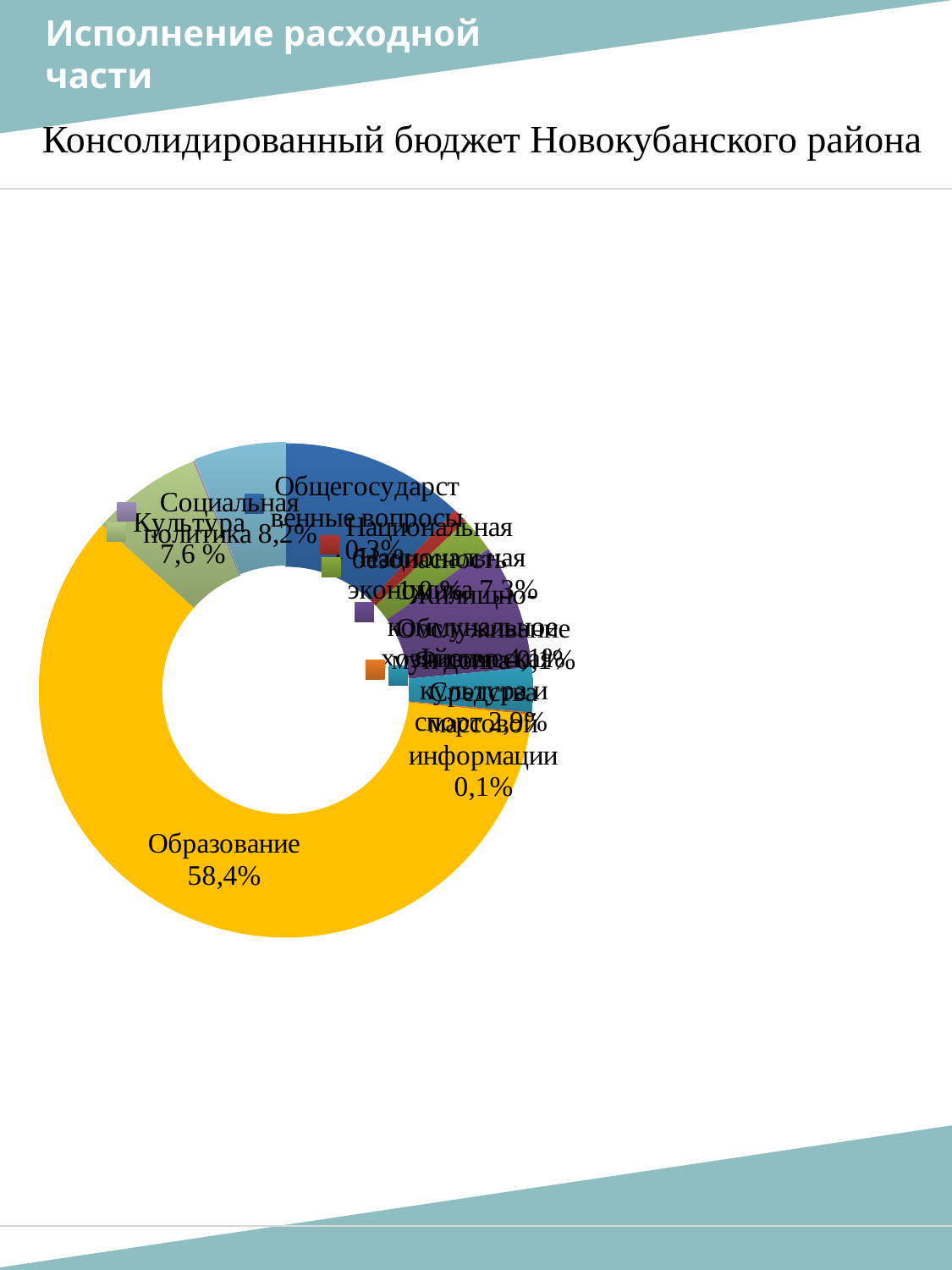
What share is shown for Средства массовой информации? 0,1% By how many percentage points does Образование exceed Социальная политика? 50,2 What kind of chart is shown on the slide? doughnut (pie) chart What share is shown for Социальная политика? 8,2% What share is shown for Культура? 7,6 % What colour is the Образование slice? yellow Which category has the largest share of expenditure? Образование By how many percentage points does Социальная политика exceed Культура? 0,6 What share of the consolidated budget expenditure goes to Образование? 58,4% Which is larger, the share for Социальная политика or for Культура? Социальная политика What is the title written above the chart? Консолидированный бюджет Новокубанского района Is the share for Образование greater or less than 50%? greater